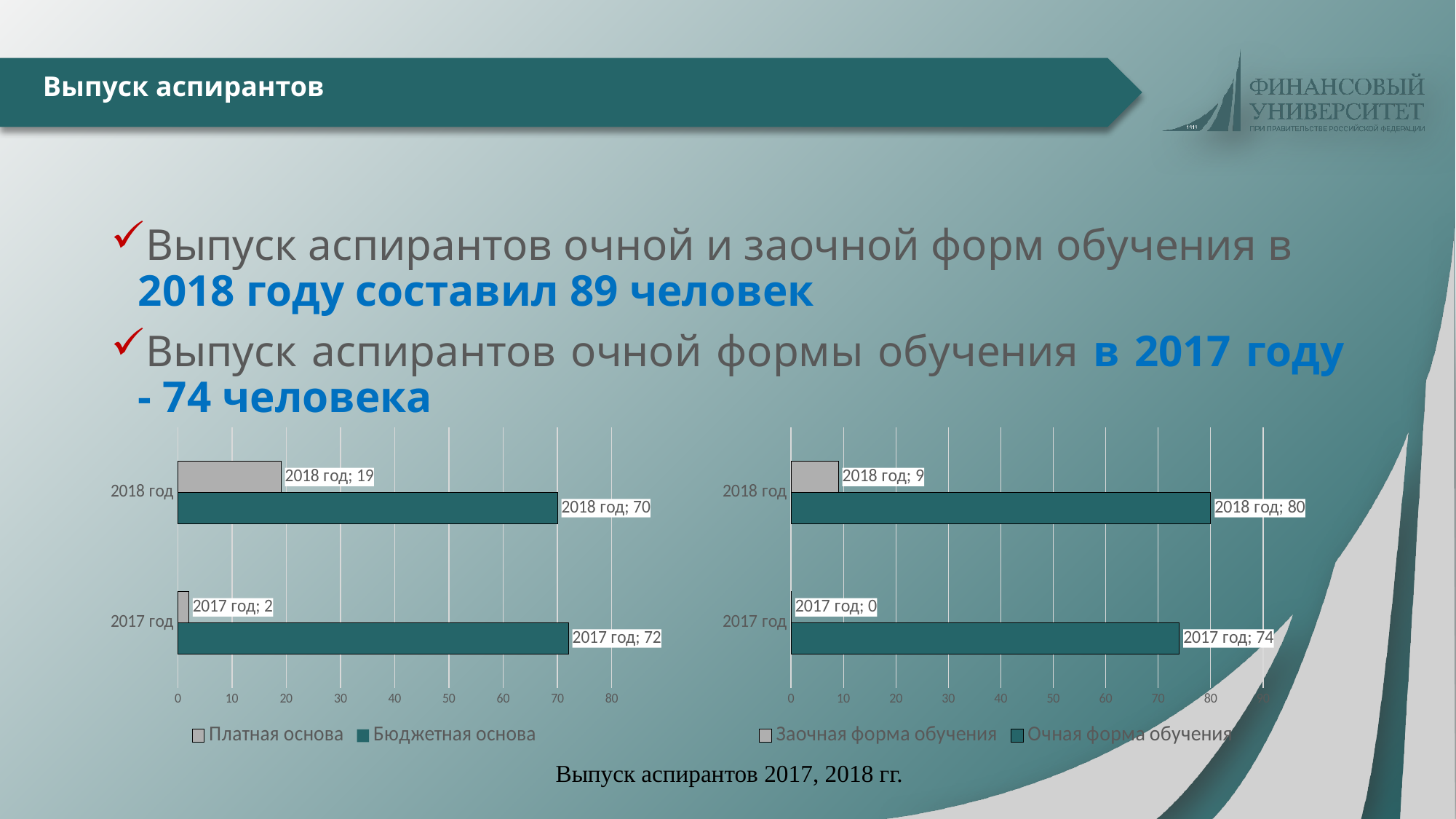
In the right chart, what is the value for Заочная форма обучения in 2017 год? 0 In the left chart, what is the difference between the Платная основа values for 2018 год and 2017 год? 17 What are the two legend entries of the left chart? Платная основа, Бюджетная основа In the right chart, which year has the higher value for Заочная форма обучения? 2018 год What type of chart is the left chart? Bar chart In the left chart, what is the total of Платная основа and Бюджетная основа for 2018 год? 89 In the right chart, what is the difference between the Очная форма обучения values for 2018 год and 2017 год? 6 In the right chart, what is the value for Очная форма обучения in 2018 год? 80 In the left chart, which is larger: Бюджетная основа in 2017 год or Бюджетная основа in 2018 год? 2017 год How many series does the legend of the right chart list? 2 In the left chart, what is the value for Платная основа in 2017 год? 2 In the left chart, what is the value for Бюджетная основа in 2018 год? 70